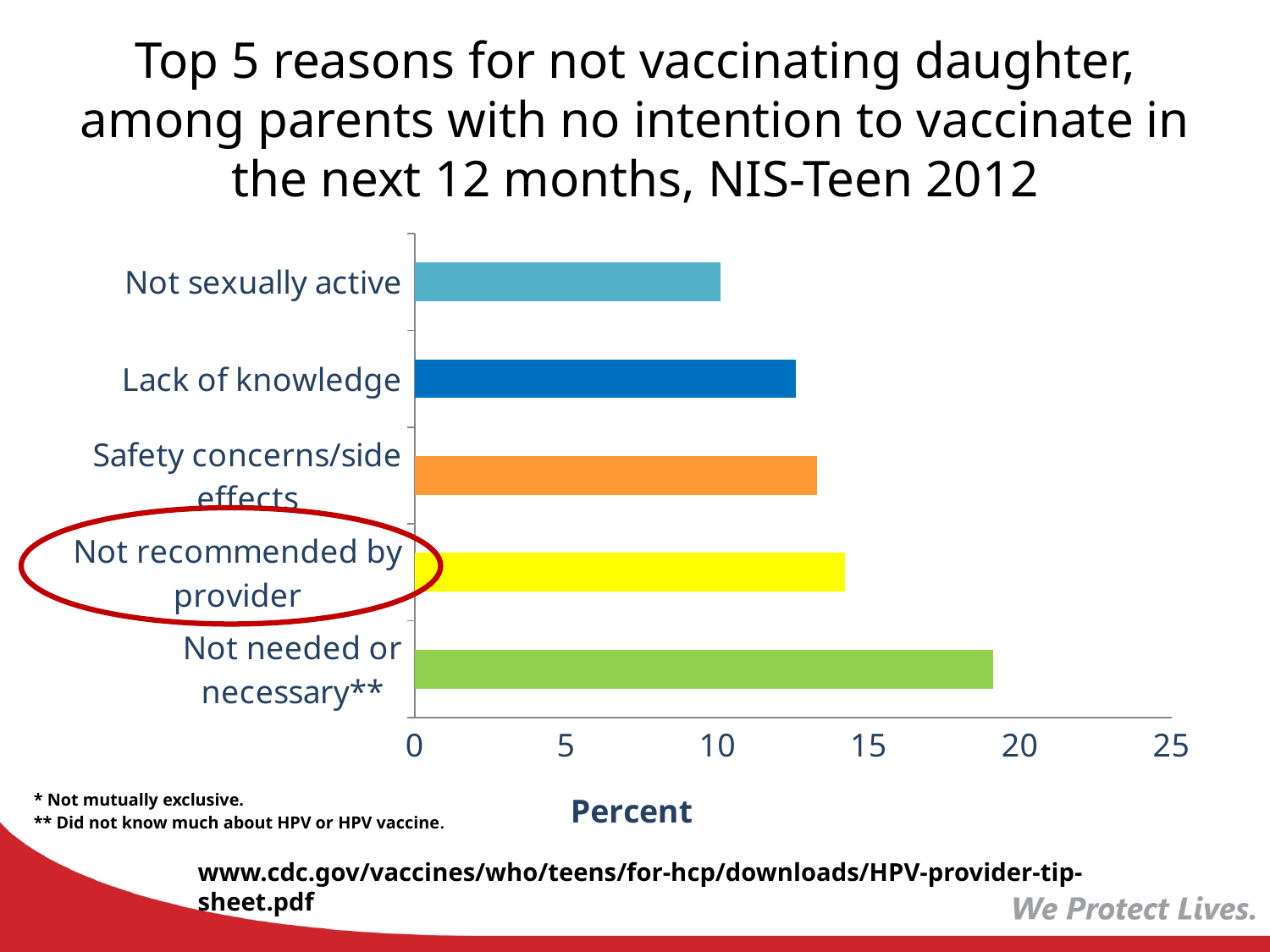
Which reason has the lowest percentage? Not sexually active What kind of chart is shown on the slide? bar chart Is the value for Not needed or necessary** greater or less than 15? greater Which reason has the highest percentage? Not needed or necessary** What is the label on the x axis of the chart? Percent Which is larger: the value for Not recommended by provider or the value for Lack of knowledge? Not recommended by provider Is the value for Not recommended by provider greater or less than 15? less Which category label is circled in red on the slide? Not recommended by provider Is the value for Lack of knowledge greater or less than 10? greater Which is larger: the value for Not needed or necessary** or the value for Not sexually active? Not needed or necessary** How many reasons (categories) are plotted in the chart? 5